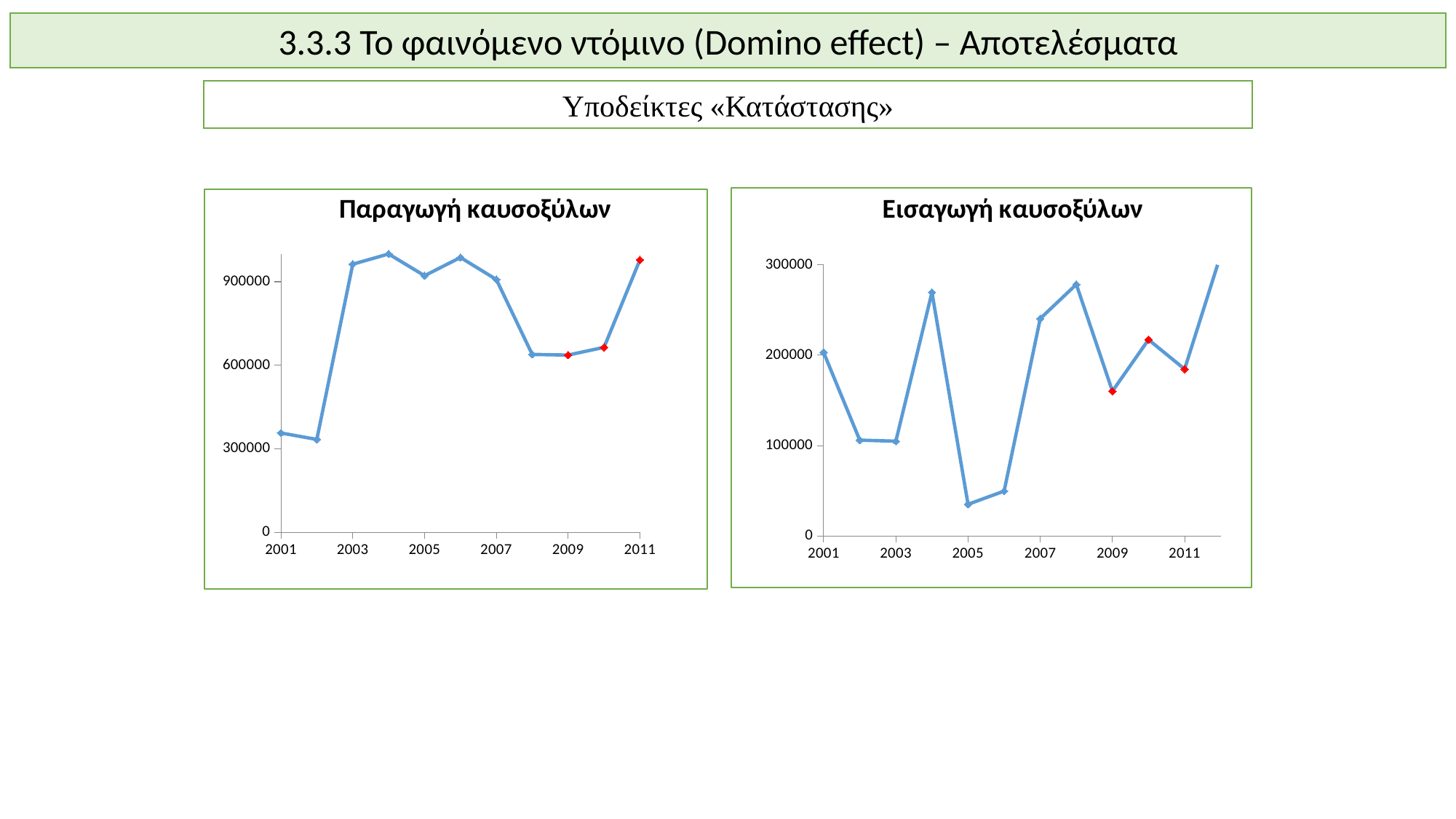
In the 'Παραγωγή καυσοξύλων' chart, is the value for 2003 greater or less than 900000? greater In the 'Εισαγωγή καυσοξύλων' chart, is the value for 2004 greater or less than 200000? greater In the 'Παραγωγή καυσοξύλων' chart, is the value for 2009 greater or less than 600000? greater In the 'Παραγωγή καυσοξύλων' chart, which is larger, the value for 2002 or the value for 2003? 2003 In the 'Παραγωγή καυσοξύλων' chart, how many years are plotted? 11 In the 'Εισαγωγή καυσοξύλων' chart, which year has the lowest value? 2005 In the 'Παραγωγή καυσοξύλων' chart, do the values rise or fall from 2009 to 2011? rise What is the title of the chart on the right of the slide? Εισαγωγή καυσοξύλων What kind of chart is the 'Παραγωγή καυσοξύλων' chart on the left? line chart In the 'Εισαγωγή καυσοξύλων' chart, which is larger, the value for 2008 or the value for 2009? 2008